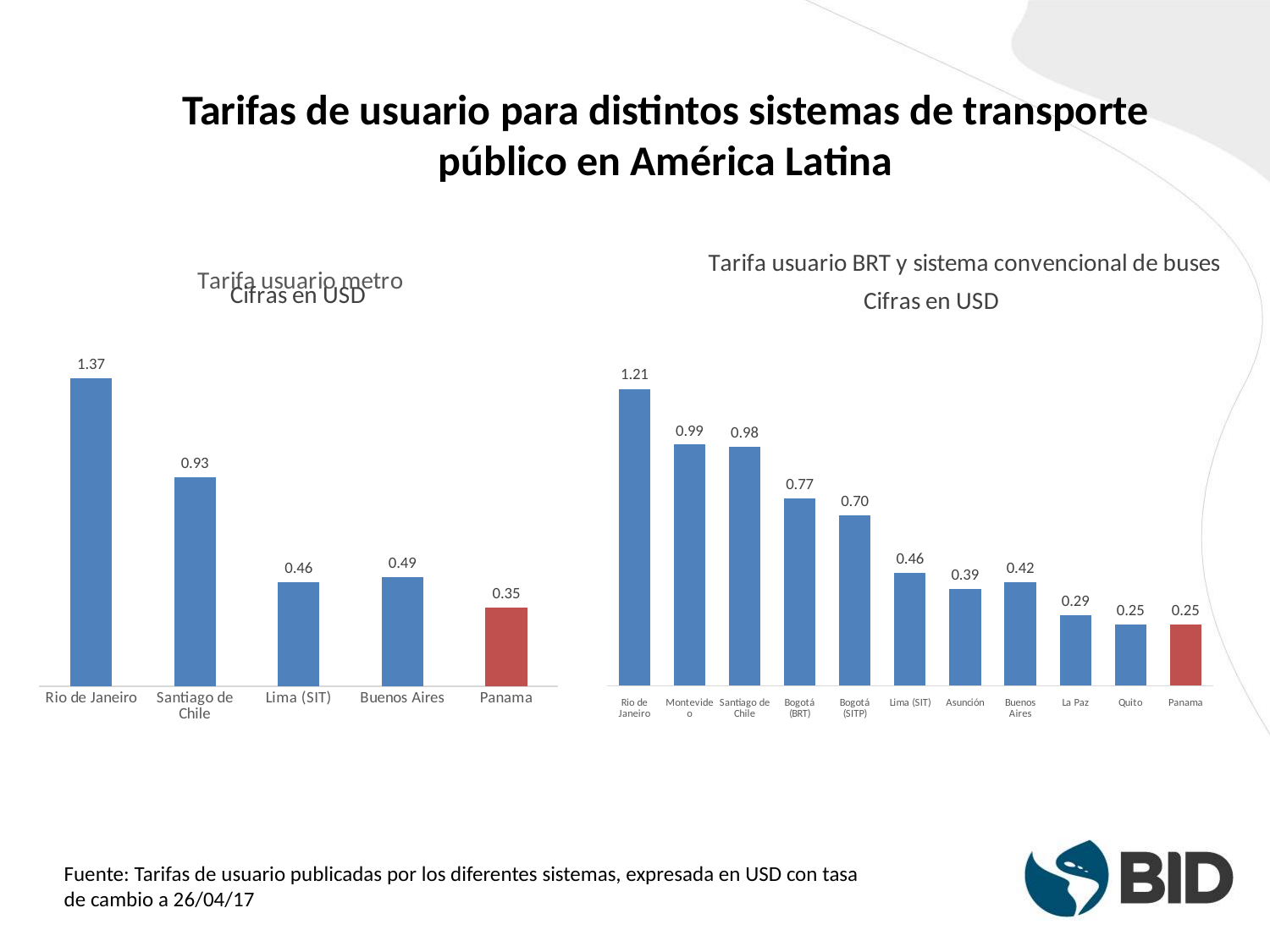
In the 'Tarifa usuario BRT y sistema convencional de buses' chart, which category has the highest value? Rio de Janeiro In the 'Tarifa usuario BRT y sistema convencional de buses' chart, what is the value for Bogotá (SITP)? 0.70 What kind of chart is the 'Tarifa usuario metro' chart? Bar chart In the 'Tarifa usuario BRT y sistema convencional de buses' chart, what is the difference between Montevideo and La Paz? 0.70 In the 'Tarifa usuario BRT y sistema convencional de buses' chart, which bar is coloured red instead of blue? Panama In the 'Tarifa usuario BRT y sistema convencional de buses' chart, which is larger, Asunción or Buenos Aires? Buenos Aires In the 'Tarifa usuario BRT y sistema convencional de buses' chart, how many categories are shown? 11 In the 'Tarifa usuario metro' chart, how many categories are shown? 5 In the 'Tarifa usuario metro' chart, which is larger, Lima (SIT) or Buenos Aires? Buenos Aires In the 'Tarifa usuario metro' chart, what is the value for Rio de Janeiro? 1.37 In the 'Tarifa usuario metro' chart, what is the difference between Santiago de Chile and Lima (SIT)? 0.47 In the 'Tarifa usuario metro' chart, which category has the lowest value? Panama